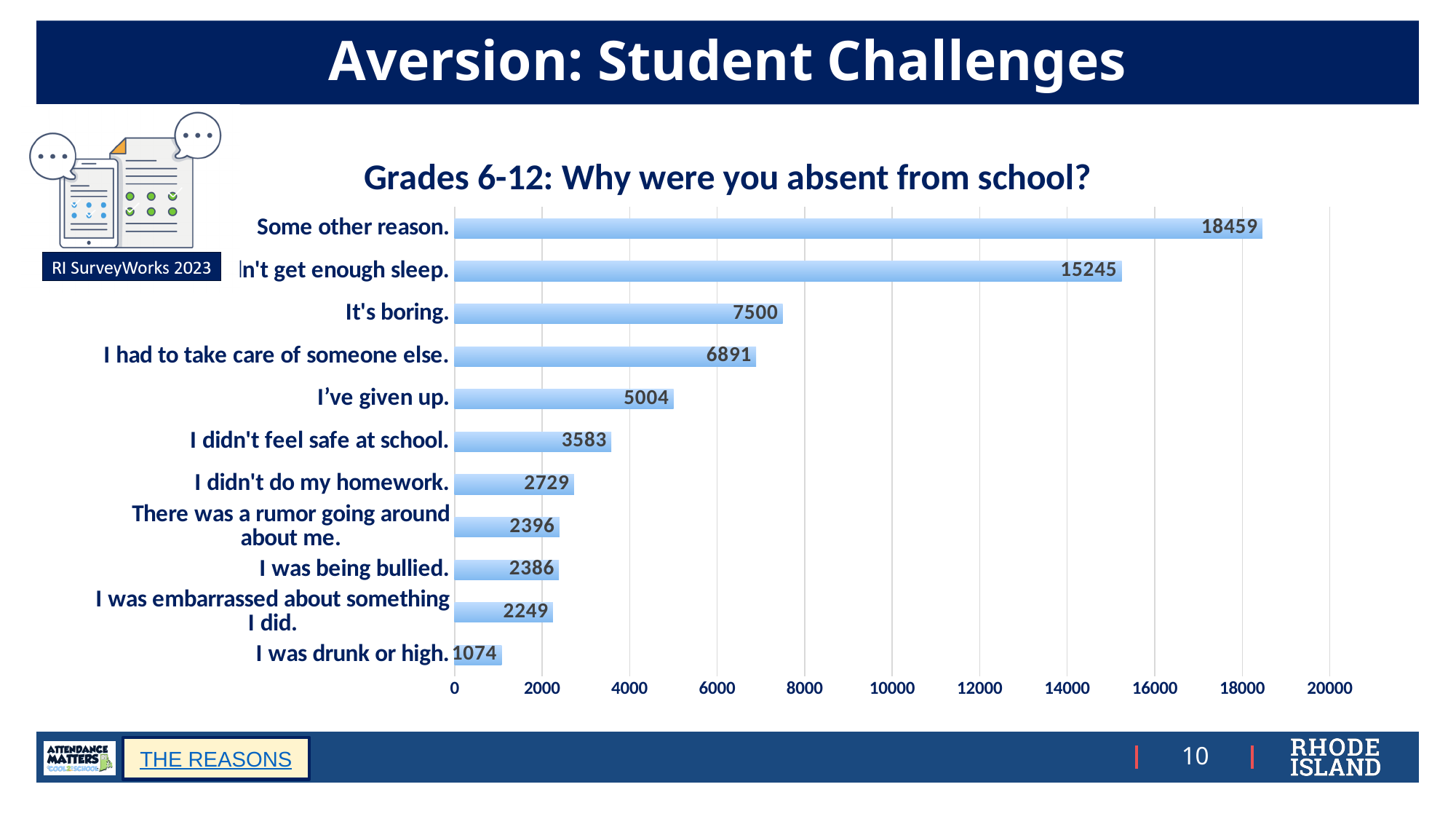
What is the value for "I didn't feel safe at school."? 3583 What is the difference between the values for "Some other reason." and "It's boring."? 10959 What is the difference between the values for "I've given up." and "I was drunk or high."? 3930 What is the value for "I had to take care of someone else."? 6891 What type of chart is shown on the slide? bar chart What is the value for "It's boring."? 7500 What is the value for "I was drunk or high."? 1074 How many reasons (categories) are plotted in the chart? 11 Which reason has the highest value? Some other reason. Which is larger, the value for "I didn't do my homework." or the value for "I was embarrassed about something I did."? I didn't do my homework. Which reason has the lowest value? I was drunk or high. What is the title of the chart? Grades 6-12: Why were you absent from school?